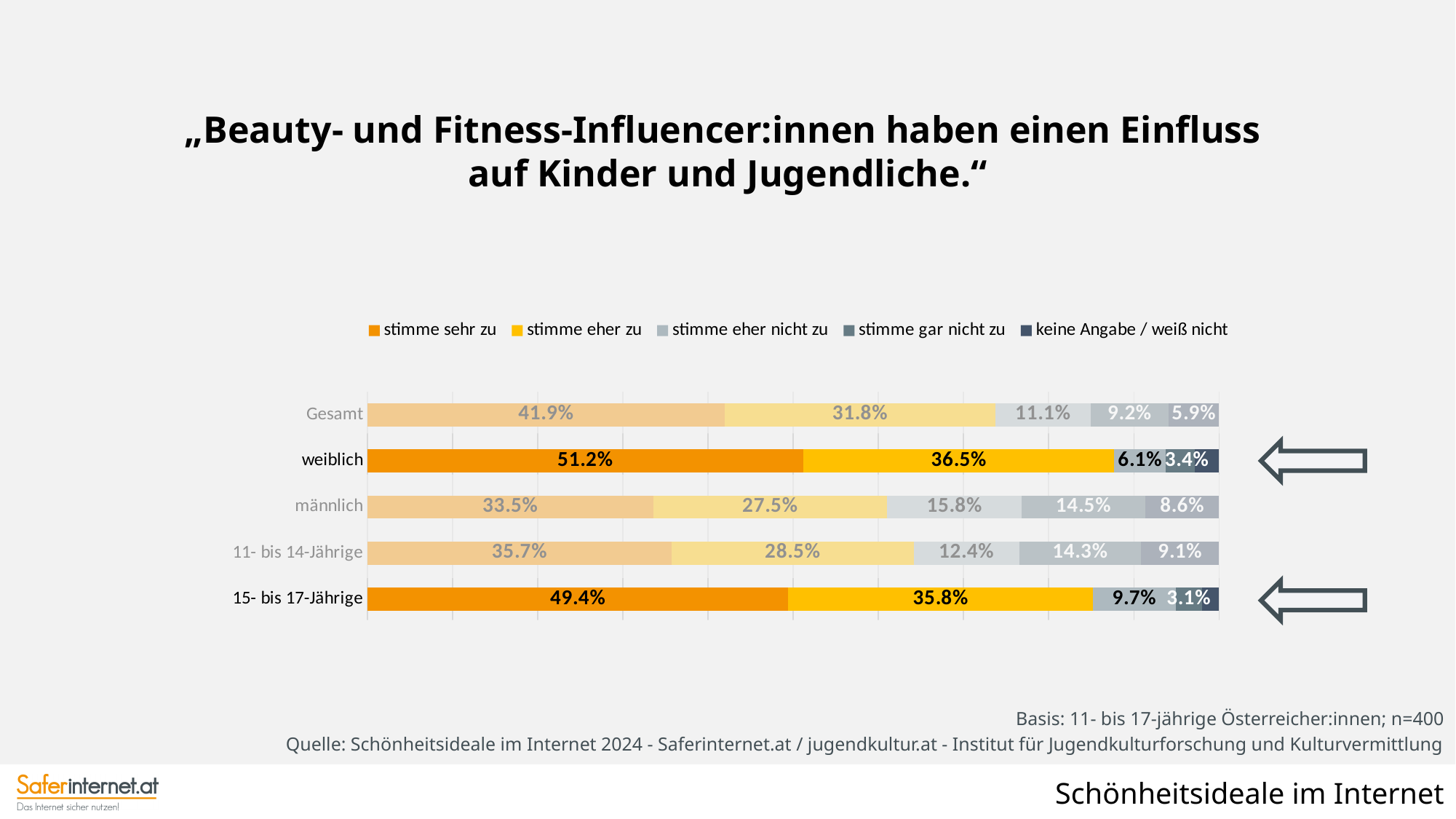
How many categories (bars) are shown in the chart? 5 Which is larger: the 'stimme eher nicht zu' value for männlich or for 11- bis 14-Jährige? männlich What kind of chart is shown on the slide? stacked bar chart How many series does the legend list? 5 Which category has the highest 'stimme sehr zu' value? weiblich What is the 'keine Angabe / weiß nicht' value for 11- bis 14-Jährige? 9.1% What is the 'stimme sehr zu' value for Gesamt? 41.9% What is the difference between the 'stimme sehr zu' values for weiblich and männlich? 17.7 percentage points Which category has the lowest 'stimme sehr zu' value? männlich What is the 'stimme eher zu' value for weiblich? 36.5% Which legend entry is shown in the darkest colour? keine Angabe / weiß nicht What is the 'stimme gar nicht zu' value for männlich? 14.5%